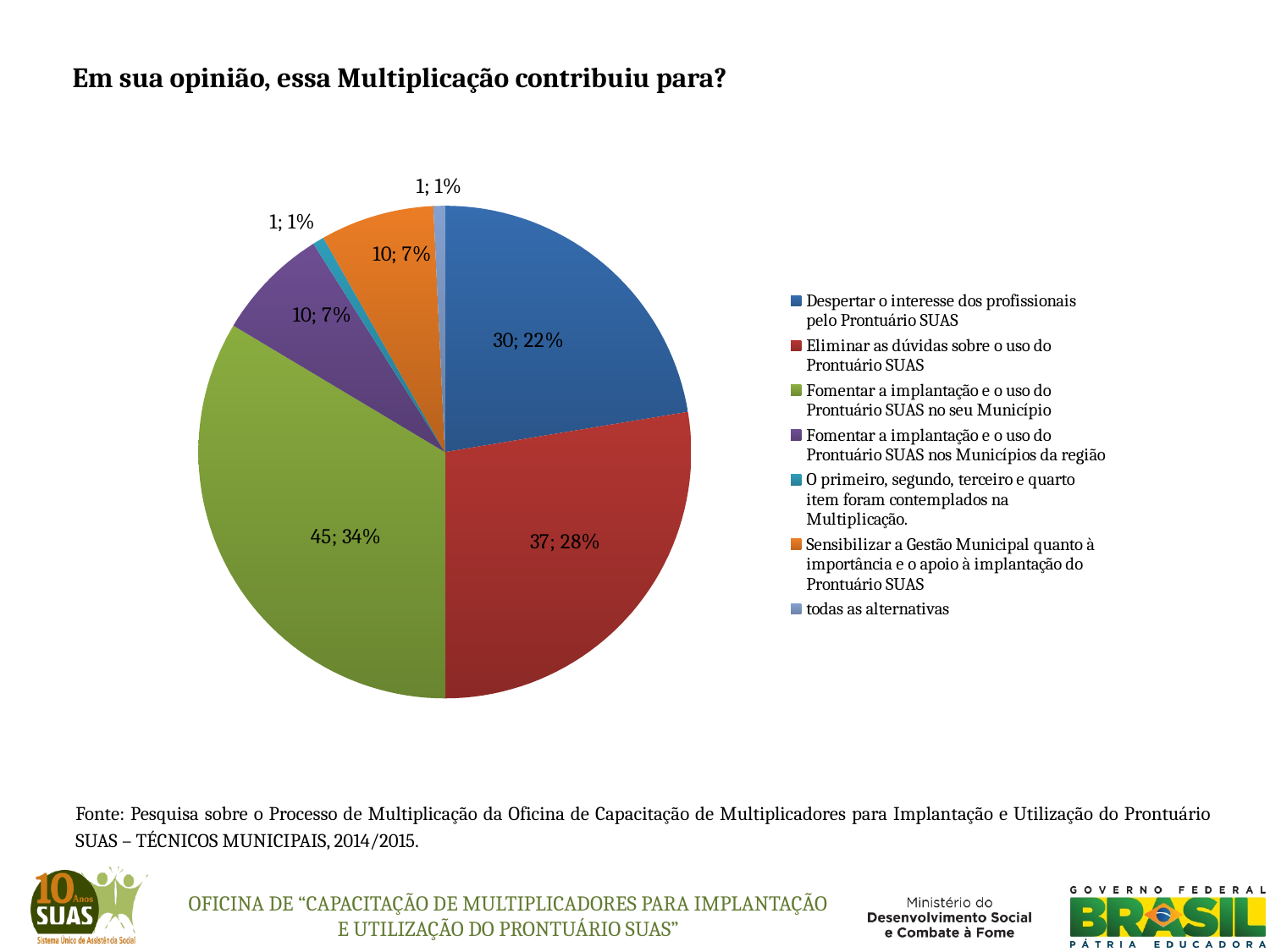
What share of the pie does 'todas as alternativas' represent? 1% Which category has the largest slice of the pie? Fomentar a implantação e o uso do Prontuário SUAS no seu Município What share of the pie does 'Sensibilizar a Gestão Municipal quanto à importância e o apoio à implantação do Prontuário SUAS' represent? 7% What is the count and share for 'Eliminar as dúvidas sobre o uso do Prontuário SUAS'? 37; 28% How many slices does the pie chart have? 7 What kind of chart is shown on the slide? pie chart Which is larger: the slice for 'Despertar o interesse dos profissionais pelo Prontuário SUAS' or the slice for 'Eliminar as dúvidas sobre o uso do Prontuário SUAS'? Eliminar as dúvidas sobre o uso do Prontuário SUAS How many entries does the legend list? 7 What colour is the slice for 'Fomentar a implantação e o uso do Prontuário SUAS nos Municípios da região'? purple What is the count and share for 'Despertar o interesse dos profissionais pelo Prontuário SUAS'? 30; 22% What is the difference in count between 'Fomentar a implantação e o uso do Prontuário SUAS no seu Município' and 'Eliminar as dúvidas sobre o uso do Prontuário SUAS'? 8 What is the count and share for 'Fomentar a implantação e o uso do Prontuário SUAS no seu Município'? 45; 34%